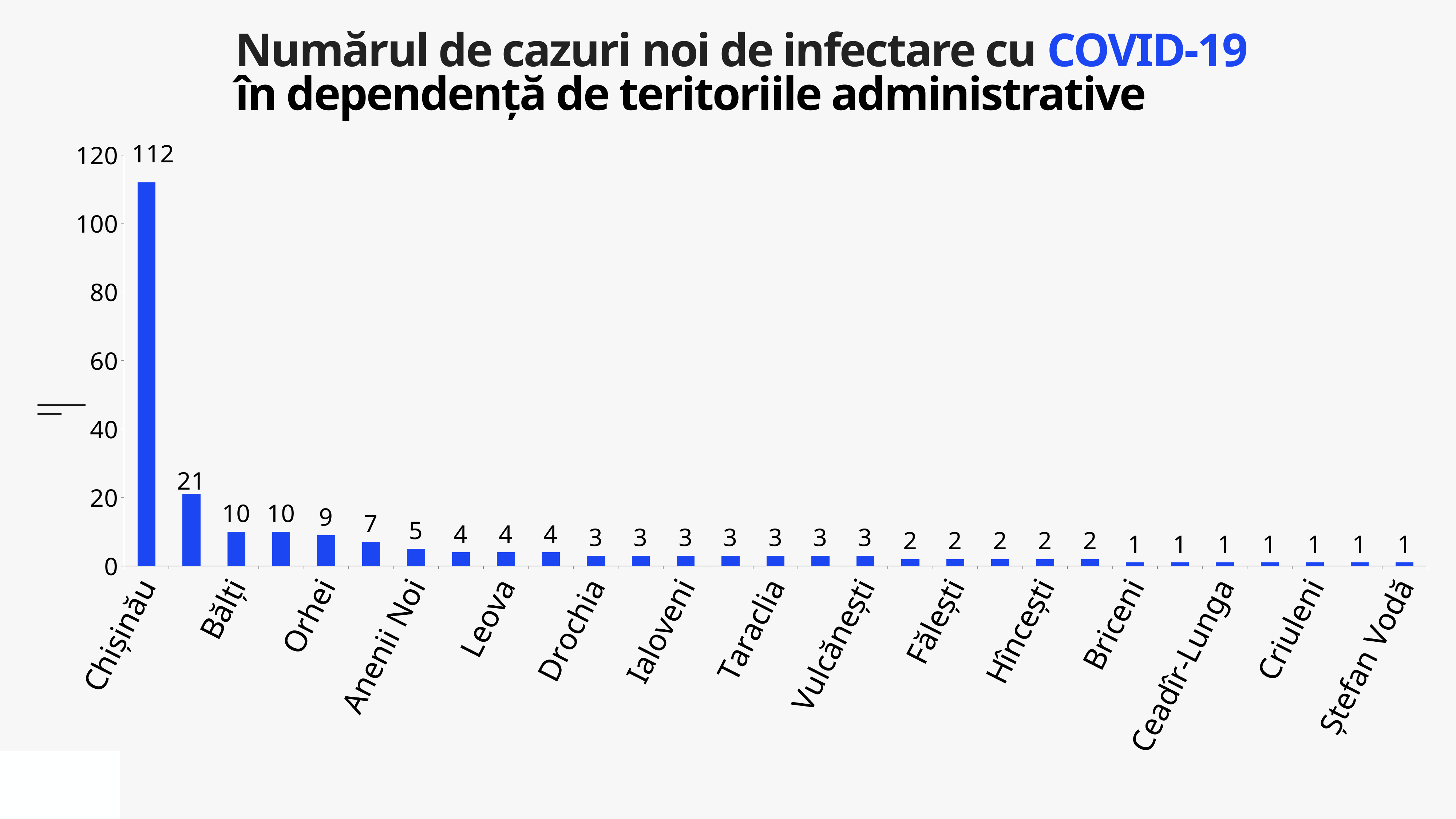
How many bars are plotted in the chart? 29 How many bars have a value of 1? 7 What is the value of the second-tallest bar in the chart? 21 What type of chart is shown on the slide? bar chart Do the bar values rise or fall from left to right along the x axis? fall What is the value shown for Chișinău? 112 What colour are the bars in the chart? blue Which territory has the highest number of new COVID-19 cases? Chișinău What is the difference between the tallest bar (112) and the second-tallest bar (21)? 91 What is the highest tick value shown on the y axis? 120 What is the smallest value shown on any bar in the chart? 1 Is the value for Chișinău greater or less than 100? greater